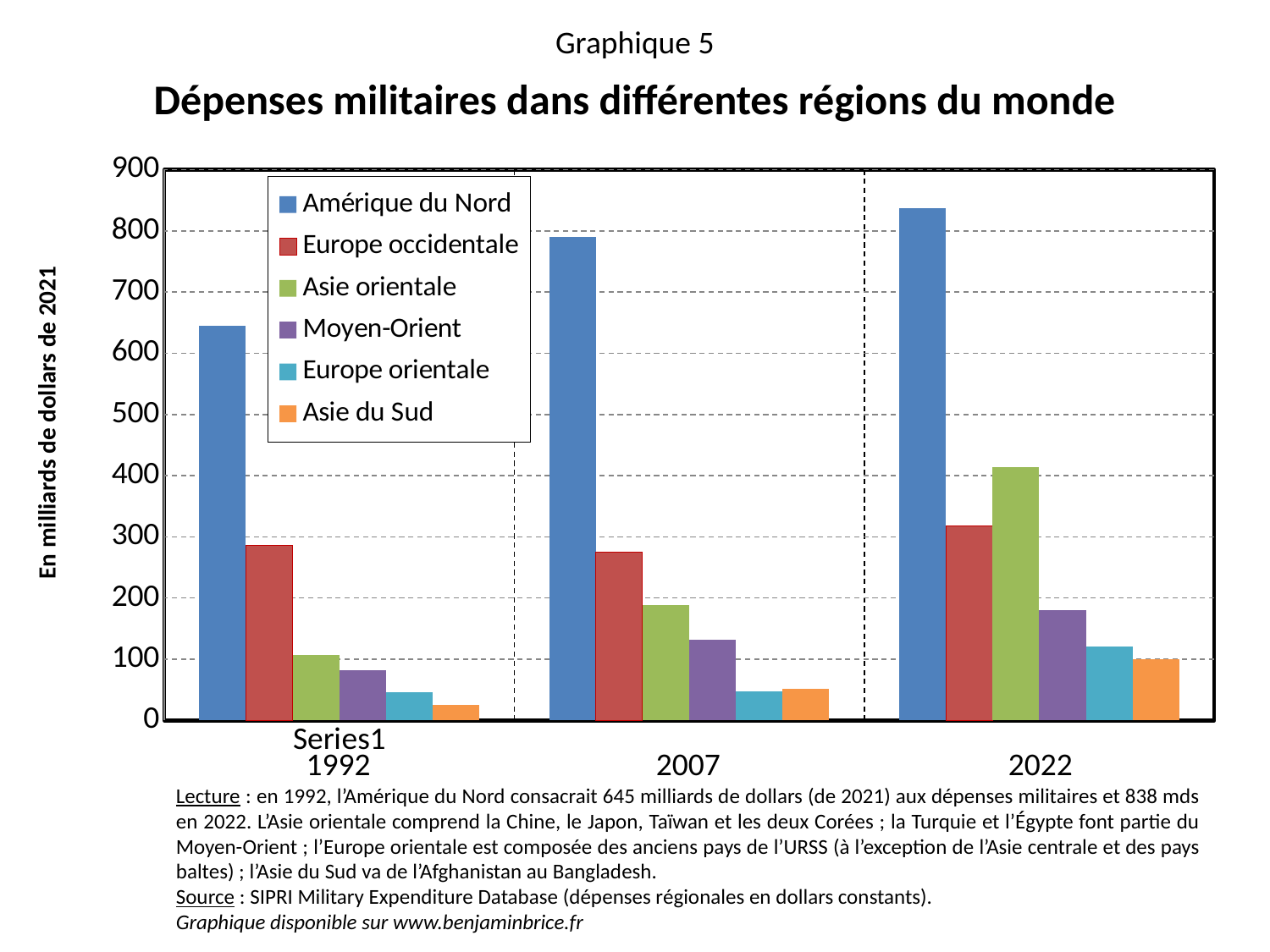
How many year groups are shown on the x axis? 3 What kind of chart is shown on the slide? bar chart In 2022, which is larger: the value for Asie orientale or the value for Europe occidentale? Asie orientale Which region has the lowest military expenditures in 1992? Asie du Sud According to the slide, what were the military expenditures of Amérique du Nord in 2022? 838 mds Is the value for Amérique du Nord in 2007 greater or less than 700? greater According to the slide, what were the military expenditures of Amérique du Nord in 1992? 645 milliards de dollars How many series does the legend list? 6 Is the value for Moyen-Orient in 2022 greater or less than 200? less By how much did the military expenditures of Amérique du Nord increase between 1992 and 2022? 193 milliards de dollars Do the military expenditures of Asie orientale rise or fall from 1992 to 2022? rise Which region has the highest military expenditures in 2022? Amérique du Nord